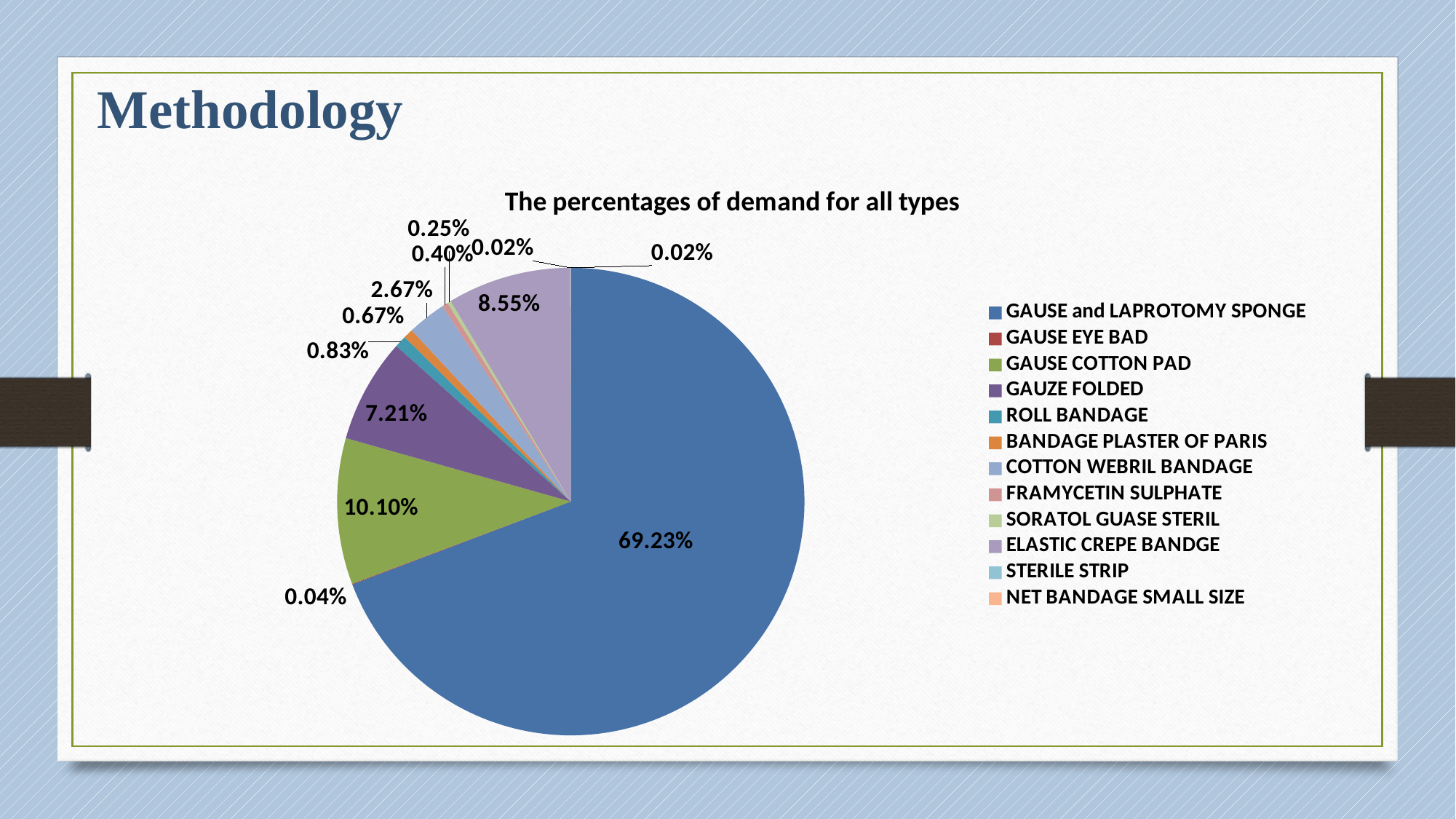
Which type has the largest share of demand? GAUSE and LAPROTOMY SPONGE What percentage of demand is for COTTON WEBRIL BANDAGE? 2.67% What is the title of the chart? The percentages of demand for all types What percentage of demand is for GAUSE COTTON PAD? 10.10% Which has a larger share of demand, GAUSE COTTON PAD or ELASTIC CREPE BANDGE? GAUSE COTTON PAD What percentage of demand is for ROLL BANDAGE? 0.83% What percentage of demand is for ELASTIC CREPE BANDGE? 8.55% How many types are listed in the chart legend? 12 What is the difference in percentage points between GAUSE COTTON PAD and GAUZE FOLDED? 2.89% What percentage of demand is for GAUZE FOLDED? 7.21% What kind of chart is shown on the slide? pie chart What percentage of demand is for GAUSE and LAPROTOMY SPONGE? 69.23%